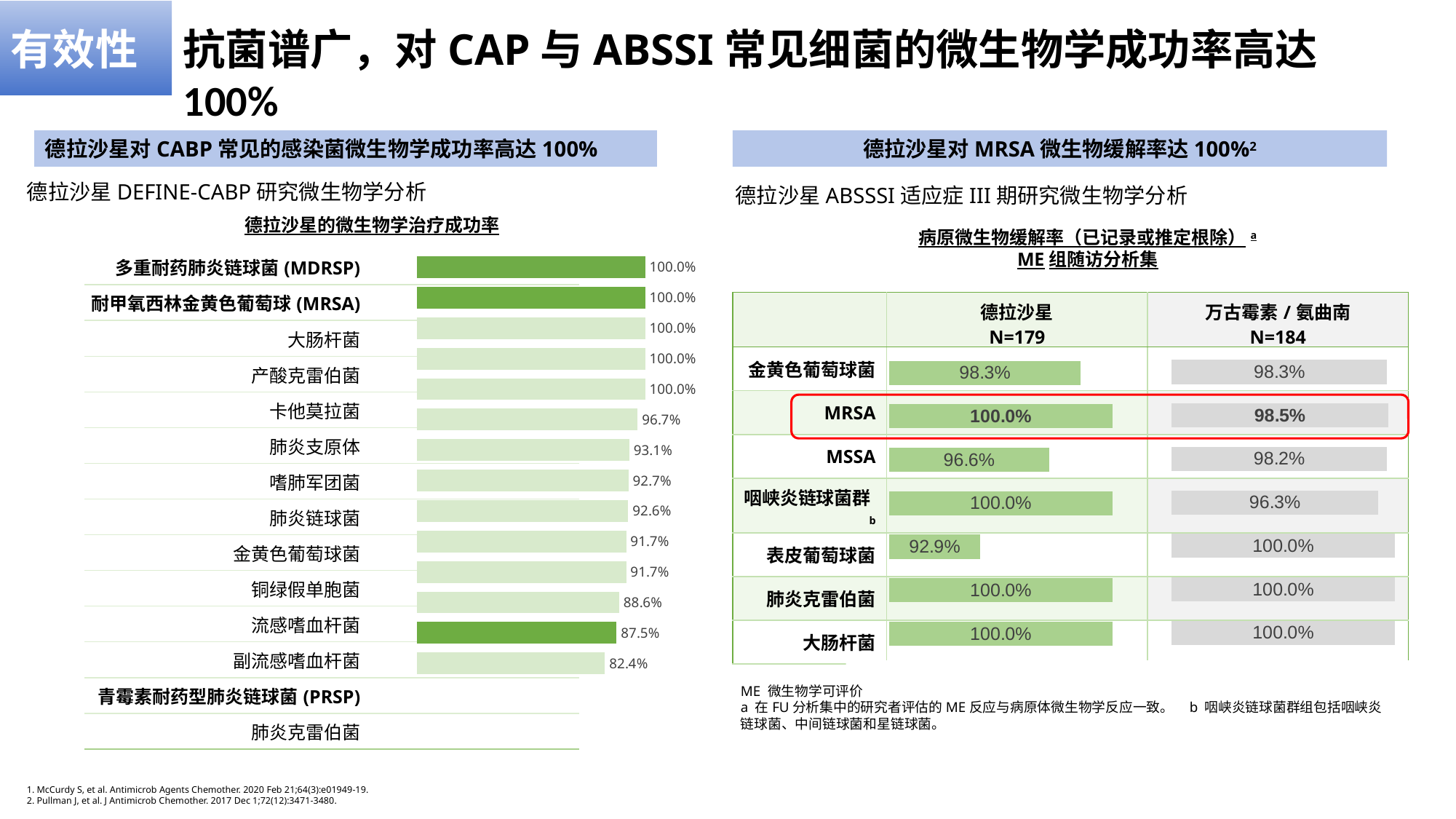
In the left chart '德拉沙星的微生物学治疗成功率', what is the lowest value shown on any bar? 82.4% In the right chart '病原微生物缓解率', which pathogen has the lowest 德拉沙星 value? 表皮葡萄球菌 In the left chart '德拉沙星的微生物学治疗成功率', what is the value for 多重耐药肺炎链球菌 (MDRSP)? 100.0% What kind of chart is the left chart '德拉沙星的微生物学治疗成功率'? bar chart In the right chart '病原微生物缓解率', which is larger for 咽峡炎链球菌群: the 德拉沙星 value or the 万古霉素 / 氨曲南 value? 德拉沙星 In the right chart '病原微生物缓解率', what is the 德拉沙星 value for MRSA? 100.0% In the right chart '病原微生物缓解率', what is the 万古霉素 / 氨曲南 value for MRSA? 98.5% In the right chart '病原微生物缓解率', what is the 德拉沙星 value for 表皮葡萄球菌? 92.9% In the left chart '德拉沙星的微生物学治疗成功率', how many bars are plotted? 14 In the left chart '德拉沙星的微生物学治疗成功率', how many bars show a value of 100.0%? 5 In the right chart '病原微生物缓解率', what is the difference between the 万古霉素 / 氨曲南 and 德拉沙星 values for MSSA? 1.6 percentage points In the right chart '病原微生物缓解率', how many treatment groups (columns) are compared? 2